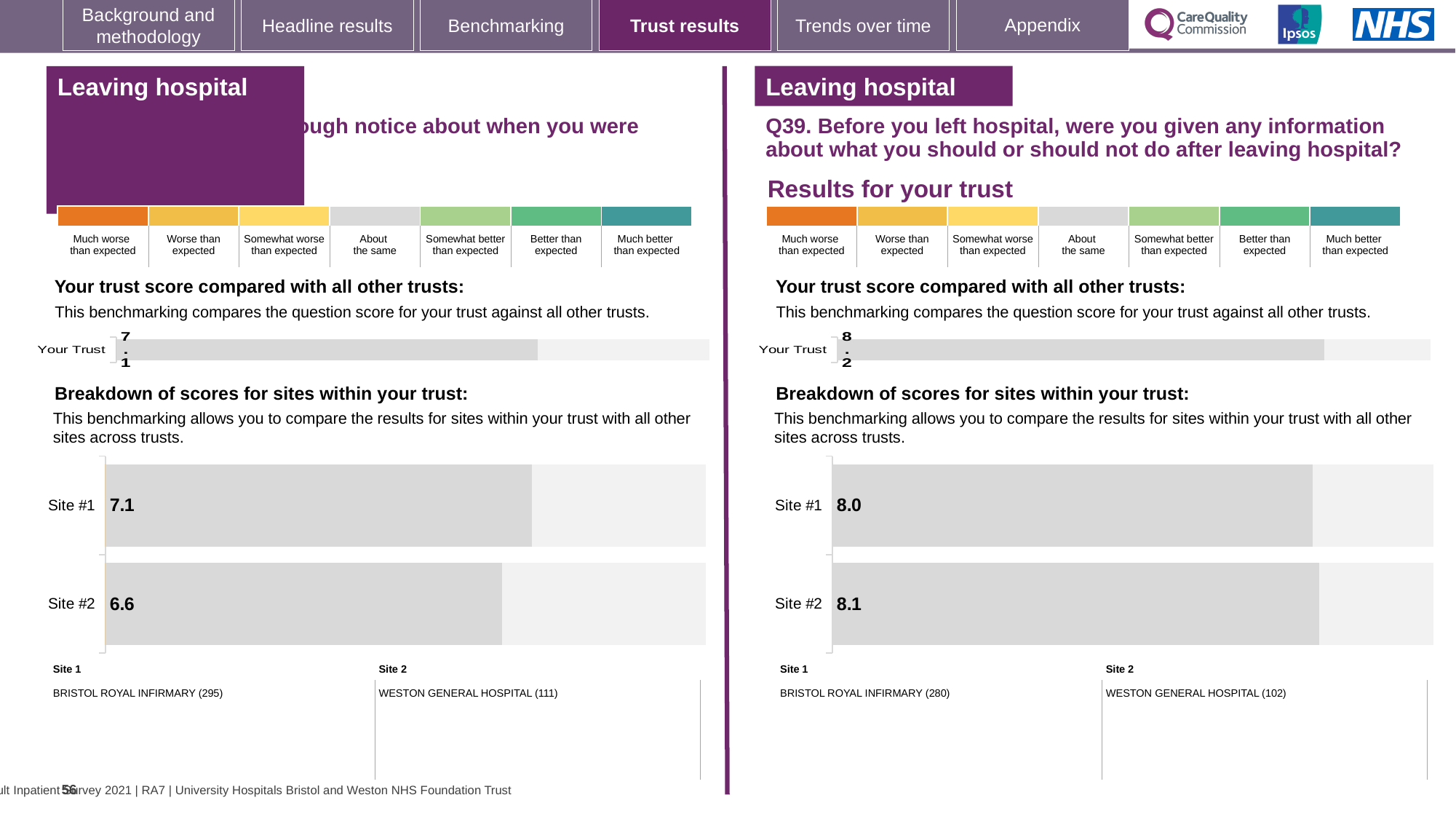
In the right-hand (Q39) 'Your trust score compared with all other trusts' chart, what is the score for Your Trust? 8.2 In the left-hand 'Breakdown of scores for sites within your trust' chart, what is the score for Site #1? 7.1 In the left-hand site breakdown chart, which site has the higher score? Site #1 In the right-hand (Q39) site breakdown chart, which site has the lower score? Site #1 In the left-hand 'Breakdown of scores for sites within your trust' chart, what is the score for Site #2? 6.6 In the right-hand (Q39) 'Breakdown of scores for sites within your trust' chart, what is the score for Site #1? 8.0 In the left-hand site breakdown chart, what is the difference between the Site #1 and Site #2 scores? 0.5 In the right-hand (Q39) site breakdown chart, what is the difference between the Site #2 and Site #1 scores? 0.1 What type of chart is the left-hand 'Breakdown of scores for sites within your trust' chart? Bar chart In the right-hand (Q39) 'Breakdown of scores for sites within your trust' chart, what is the score for Site #2? 8.1 In the left-hand 'Your trust score compared with all other trusts' chart, what is the score for Your Trust? 7.1 How many sites are shown in the right-hand (Q39) site breakdown chart? 2